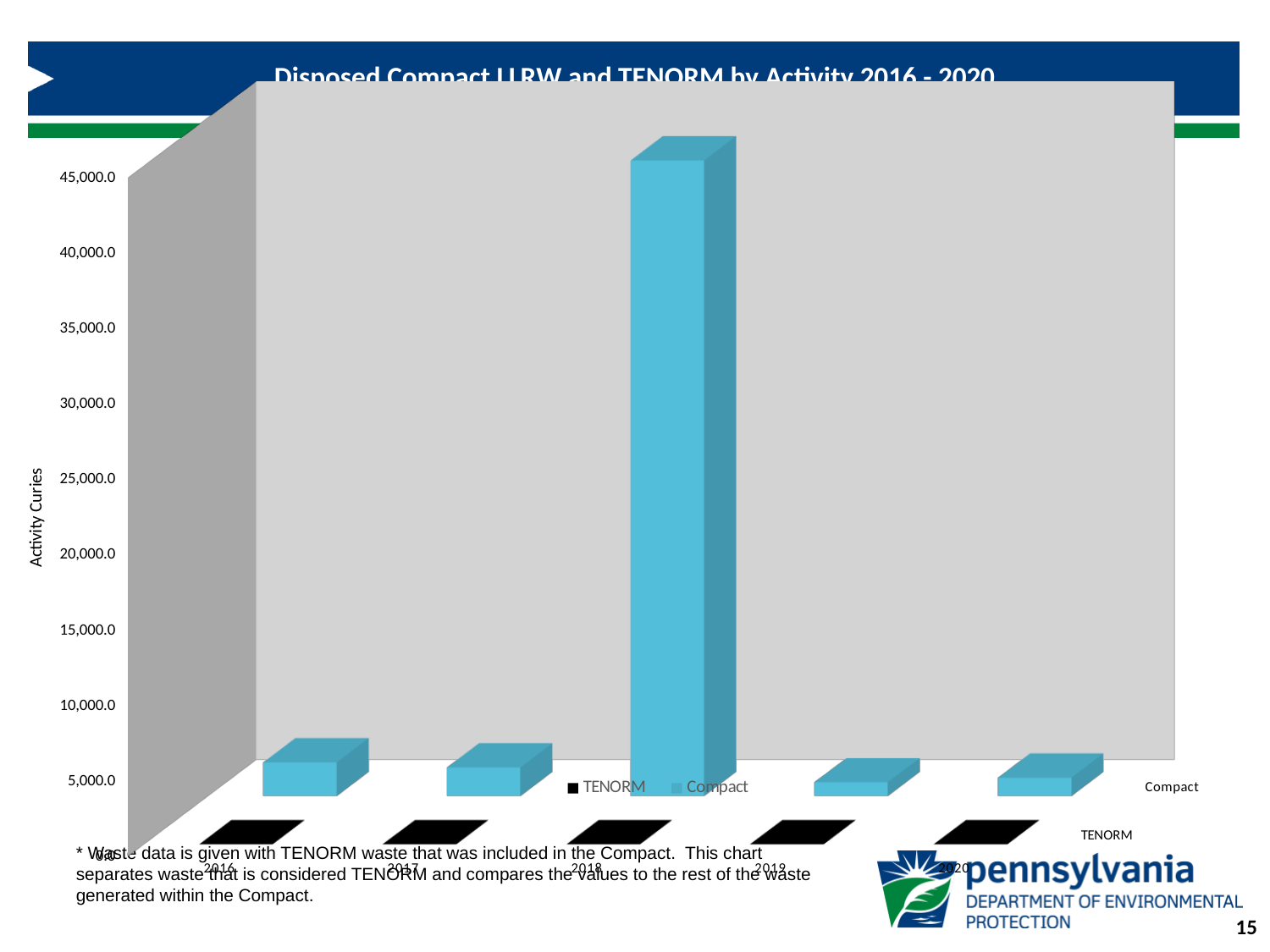
Which is larger, the Compact value for 2016 or the Compact value for 2019? 2016 What are the two series named in the legend? TENORM and Compact What kind of chart is shown on the slide? bar chart Is the Compact value for 2017 greater or less than 15,000.0? less How many series does the legend list? 2 Which year has the highest Compact value? 2018 Which is larger, the Compact value for 2018 or the Compact value for 2017? 2018 Is the Compact value for 2016 greater or less than 10,000.0? less What is the label on the vertical axis? Activity Curies How many years are shown on the x axis? 5 Is the Compact value for 2018 greater or less than 40,000.0? greater